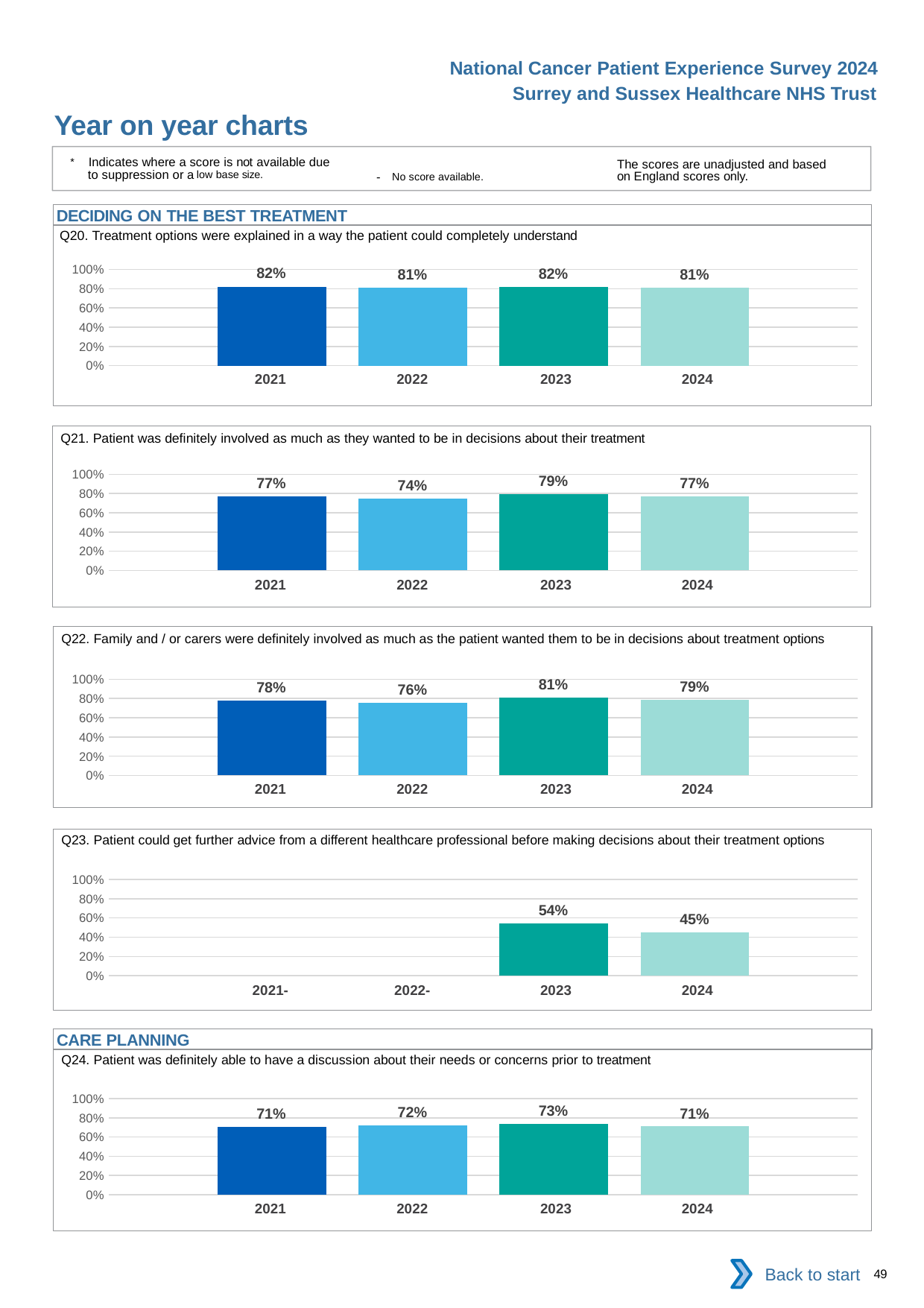
Which section heading appears above the Q24 chart? CARE PLANNING In the Q21 chart, which year has the lowest value? 2022 In the Q24 chart, which year has the highest value? 2023 In the Q21 chart, which year has the highest value? 2023 In the Q23 chart, what is the value for 2024? 45% In the Q23 chart, how many years have a bar plotted? 2 In the Q24 chart, what is the value for 2022? 72% In the Q23 chart, which is larger, the value for 2023 or the value for 2024? 2023 What kind of chart is the Q22 chart? Bar chart In the Q22 chart, what is the difference between the 2023 and 2022 values? 5 percentage points In the Q22 chart, what is the value for 2021? 78% In the Q20 chart, what is the value for 2023? 82%